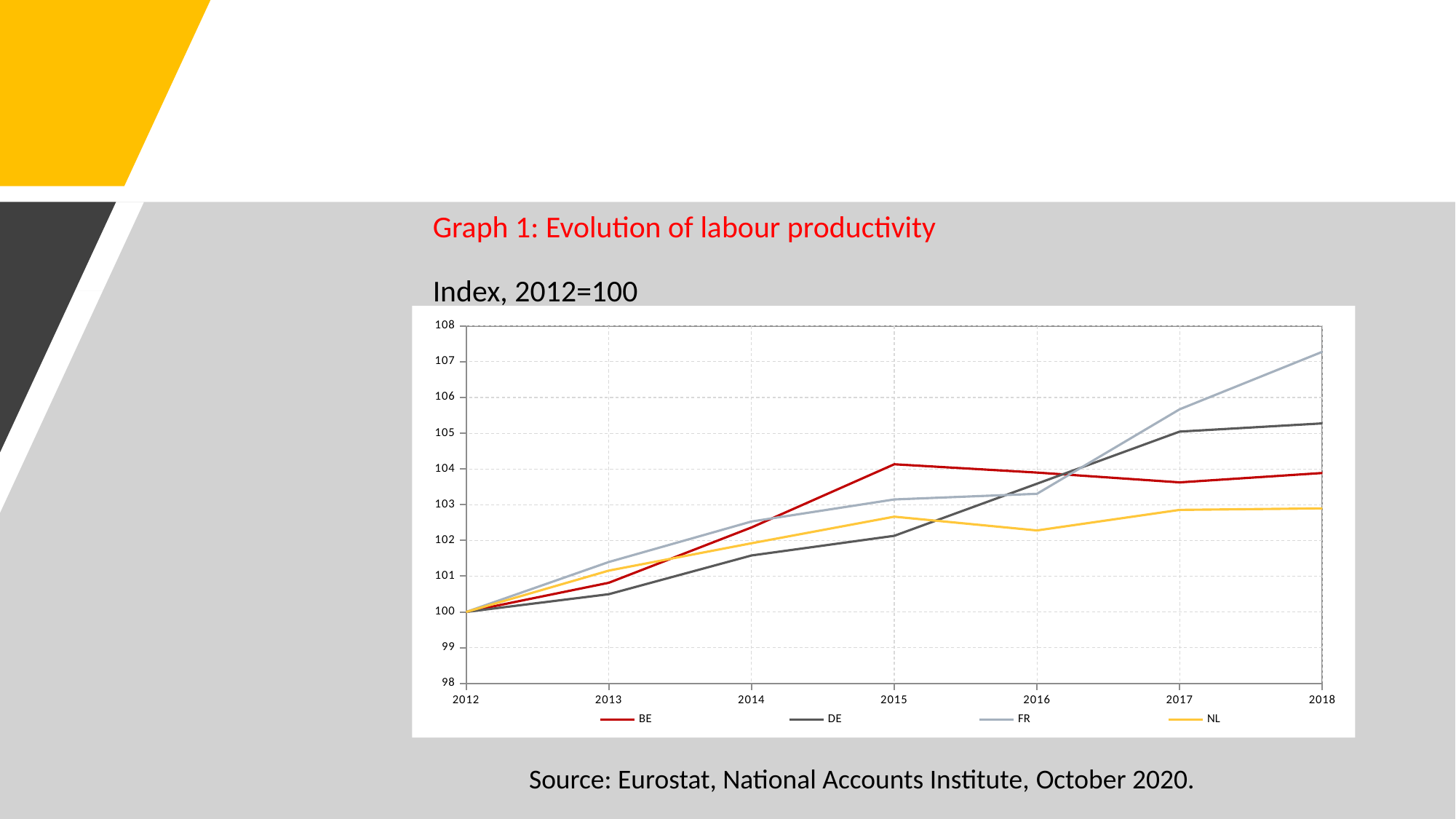
Which country has the highest labour productivity index in 2018? FR What is the index value for all four countries in 2012? 100 Does the FR line rise or fall from 2012 to 2018? rise Is the value for BE in 2015 greater or less than 103? greater What is the title of the graph? Graph 1: Evolution of labour productivity How many years are plotted along the x axis? 7 How many series does the legend list? 4 What kind of chart is shown on the slide? line chart In 2015, which is larger, the value for BE or the value for DE? BE Is the value for NL in 2016 greater or less than 103? less Which country has the lowest labour productivity index in 2018? NL Is the value for FR in 2018 greater or less than 106? greater